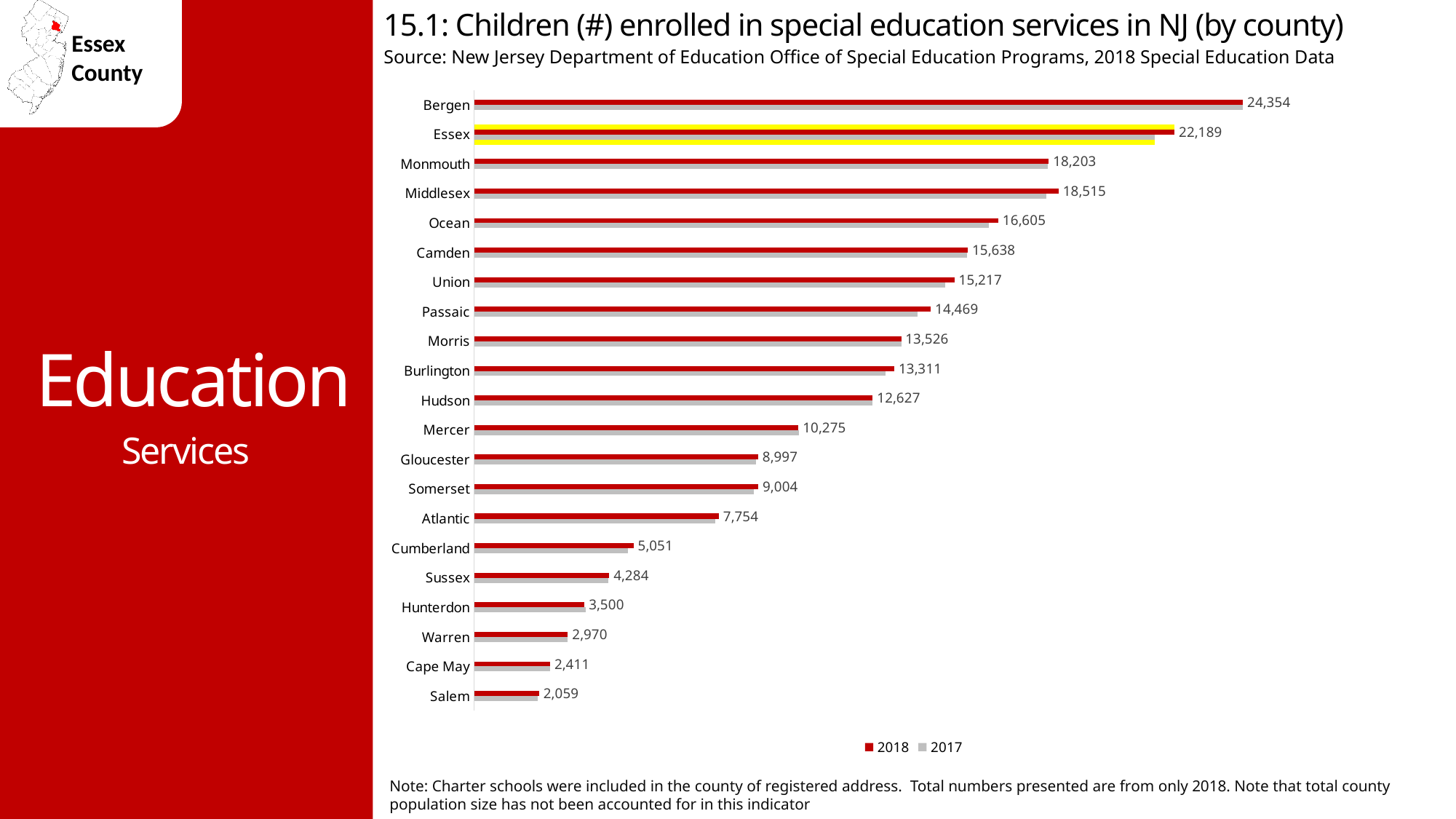
What kind of chart is shown? Bar chart How many counties are shown on the chart? 21 Which county has the highest 2018 value? Bergen How many series does the legend list? 2 What is the difference between the 2018 values for Middlesex and Monmouth? 312 Which county's bars are highlighted in yellow? Essex What is the difference between the 2018 values for Bergen and Essex? 2,165 What is the 2018 value for Salem? 2,059 Which has the larger 2018 value, Ocean or Camden? Ocean What is the 2018 value for Essex? 22,189 Which county has the lowest 2018 value? Salem What is the 2018 value for Bergen? 24,354